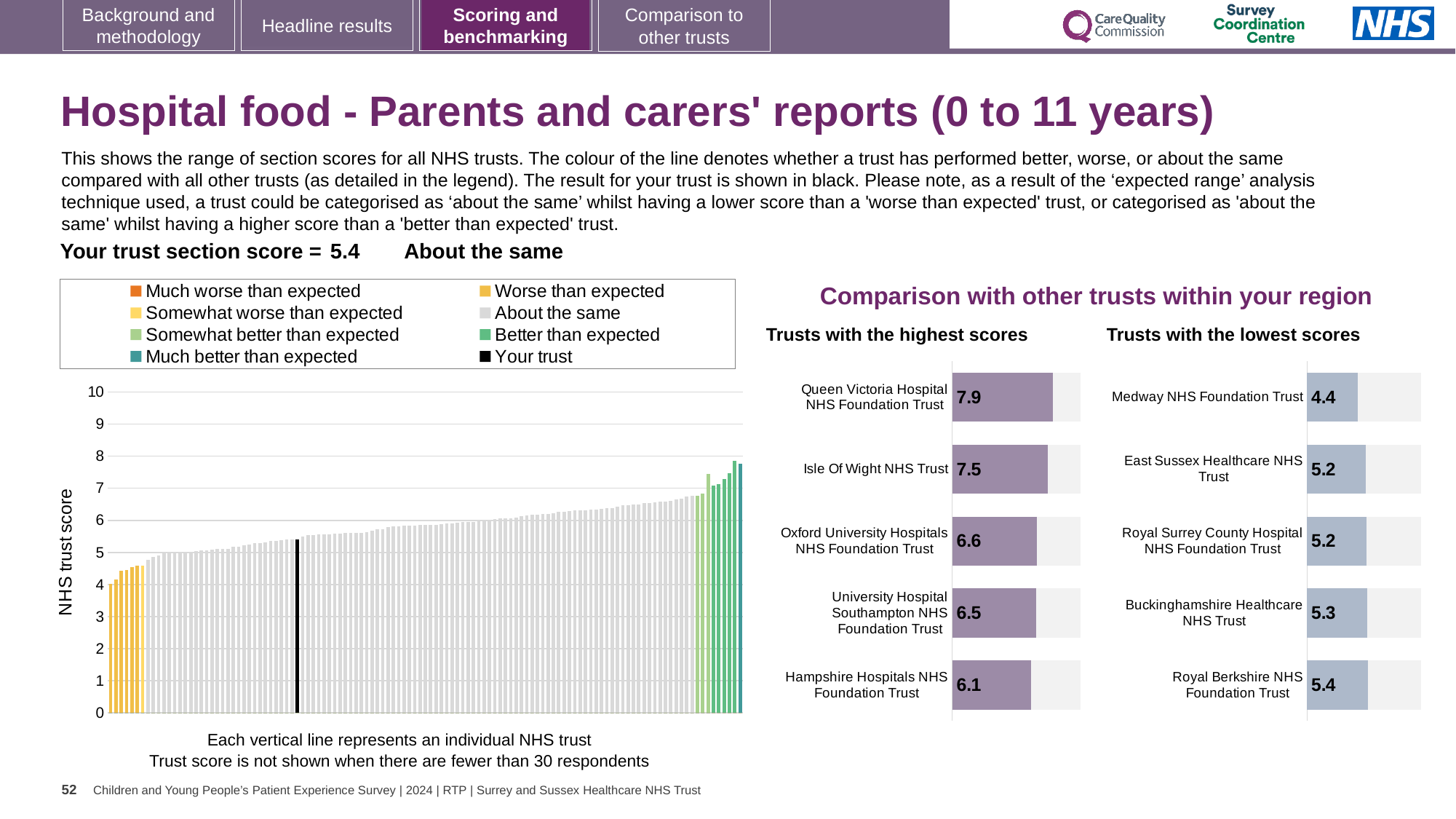
In the 'Trusts with the highest scores' chart, what is the difference between the scores of Queen Victoria Hospital NHS Foundation Trust and Hampshire Hospitals NHS Foundation Trust? 1.8 In the 'Trusts with the highest scores' chart, which trust has the highest score? Queen Victoria Hospital NHS Foundation Trust In the 'Trusts with the lowest scores' chart, which trust has the lowest score? Medway NHS Foundation Trust How many trusts are shown in the 'Trusts with the lowest scores' chart? 5 In the NHS trust score chart on the left, what is the section score for your trust (the black bar)? 5.4 In the 'Trusts with the highest scores' chart, what is the score for Hampshire Hospitals NHS Foundation Trust? 6.1 In the 'Trusts with the highest scores' chart, which has the higher score: Isle Of Wight NHS Trust or Oxford University Hospitals NHS Foundation Trust? Isle Of Wight NHS Trust How many entries does the legend of the NHS trust score chart on the left list? 8 In the 'Trusts with the lowest scores' chart, what is the score for Medway NHS Foundation Trust? 4.4 In the NHS trust score chart on the left, is the value of the lowest bar greater or less than 5? less In the 'Trusts with the highest scores' chart, what is the score for Queen Victoria Hospital NHS Foundation Trust? 7.9 In the 'Trusts with the lowest scores' chart, what is the difference between the scores of Royal Berkshire NHS Foundation Trust and Medway NHS Foundation Trust? 1.0